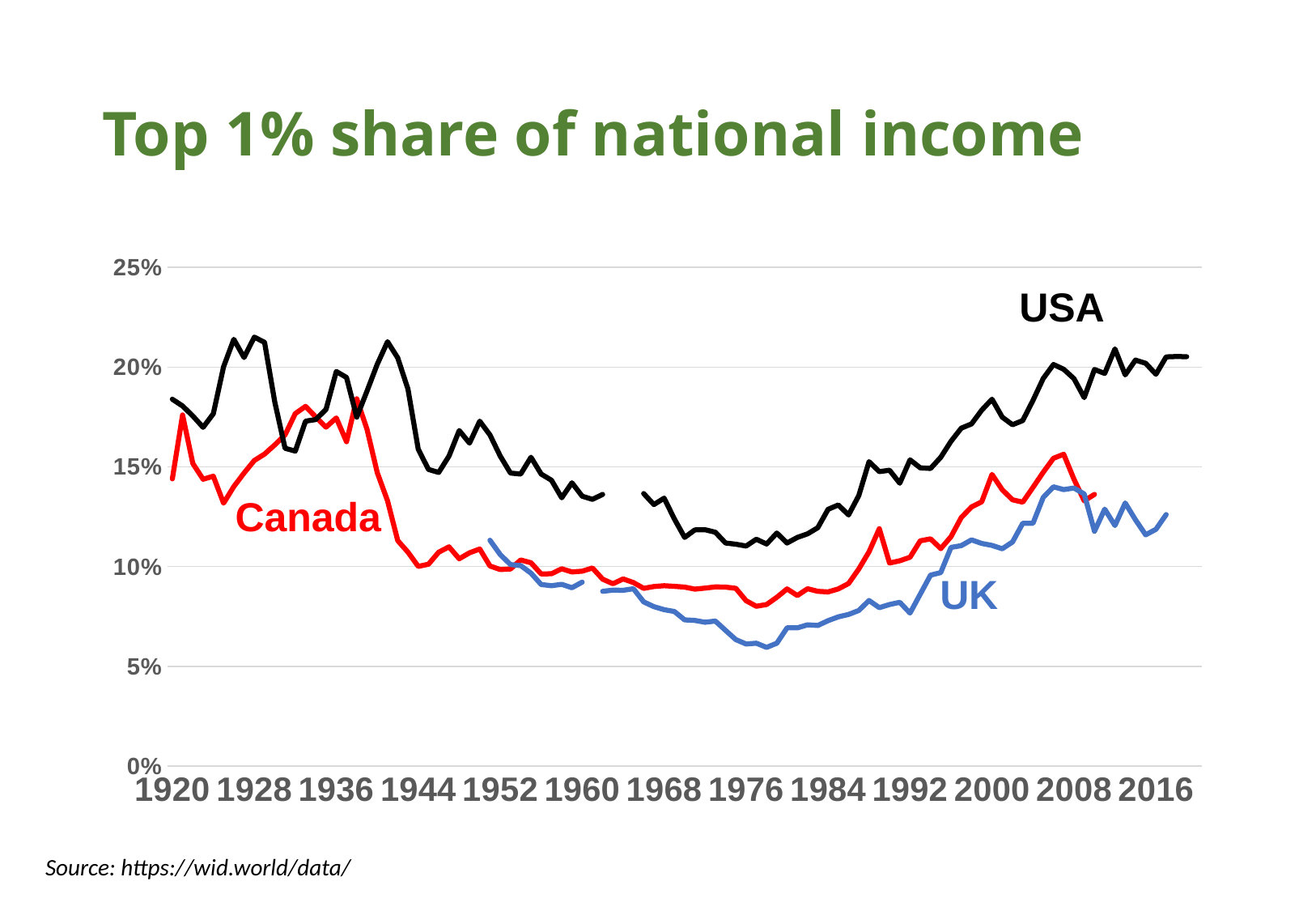
Which country has the lowest top 1% share in 1976? UK Does the USA line rise or fall between 1976 and 2016? rise Which country has the highest top 1% share in 2016? USA Is the value for Canada in 1976 greater or less than 10%? less Is the value for the USA in 1928 greater or less than 20%? greater What kind of chart is shown on the slide? line chart What is the title of the chart? Top 1% share of national income Is the value for the USA in 1976 greater or less than 15%? less Which country's line is drawn in red? Canada How many countries (series) are plotted on the chart? 3 In 2000, which is larger: the value for the USA or the value for the UK? USA